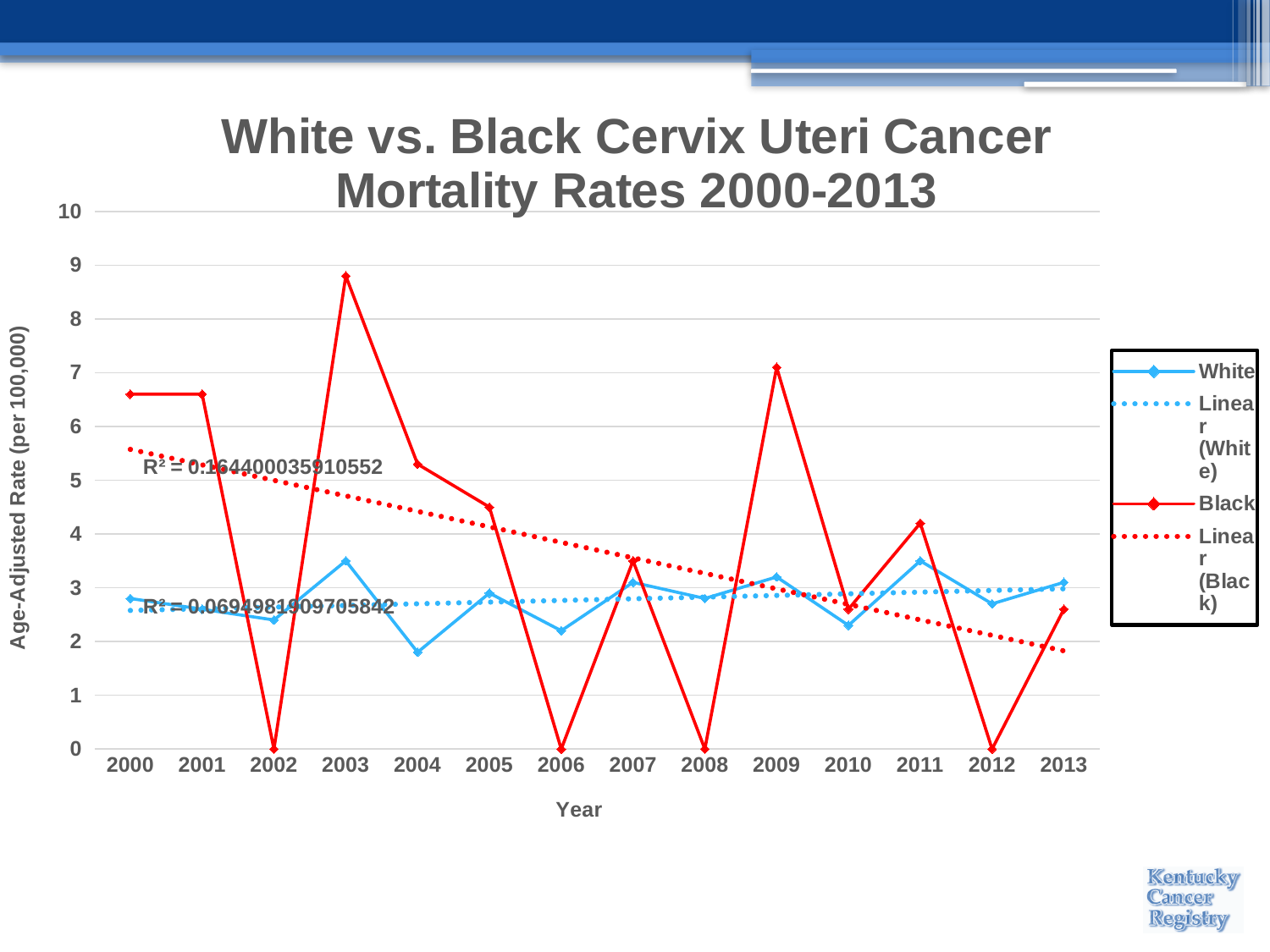
What is the label of the y axis? Age-Adjusted Rate (per 100,000) In which year is the Black mortality rate highest? 2003 Is the Black mortality rate in 2003 greater or less than 8? greater What kind of chart is shown on the slide? line chart What is the Black mortality rate in 2002? 0 In which year is the White mortality rate lowest? 2004 How many years are plotted along the x axis? 14 What is the Black mortality rate in 2012? 0 Is the White mortality rate in 2004 greater or less than 2? less How many entries does the legend list? 4 In 2002, which series has the larger value, White or Black? White Does the Linear (Black) trendline rise or fall from 2000 to 2013? fall